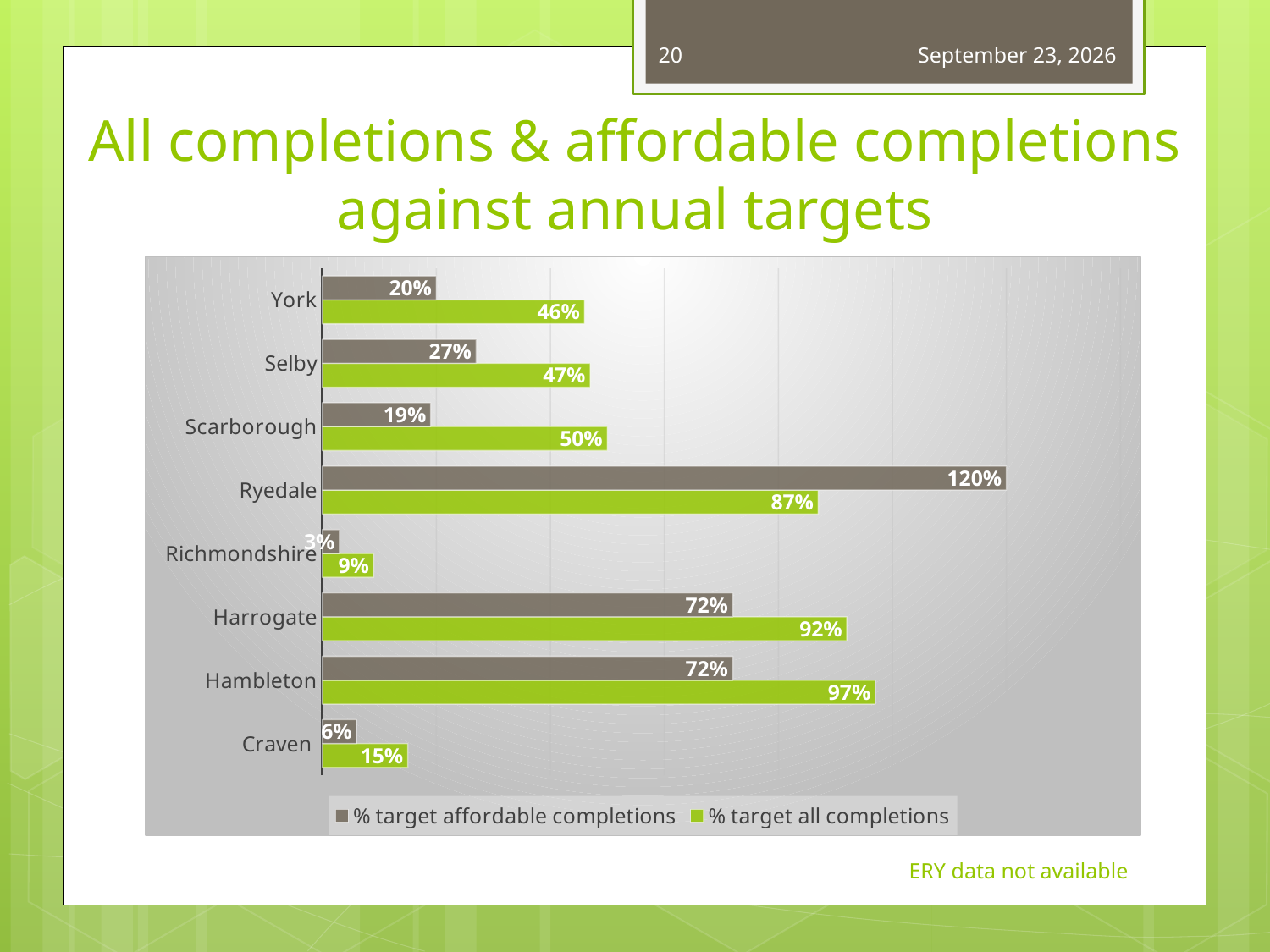
How many districts are shown on the chart? 8 What is the % target all completions value for Scarborough? 50% Which is larger for Selby: % target affordable completions or % target all completions? % target all completions What kind of chart is shown on the slide? Bar chart What is the % target affordable completions value for Ryedale? 120% Which district has the highest % target all completions? Hambleton How many series does the legend list? 2 What is the % target affordable completions value for Craven? 6% What is the difference between the % target all completions and the % target affordable completions for York? 26% Which district has the lowest % target affordable completions? Richmondshire What is the % target all completions value for Hambleton? 97% Which colour represents % target all completions in the chart? Green